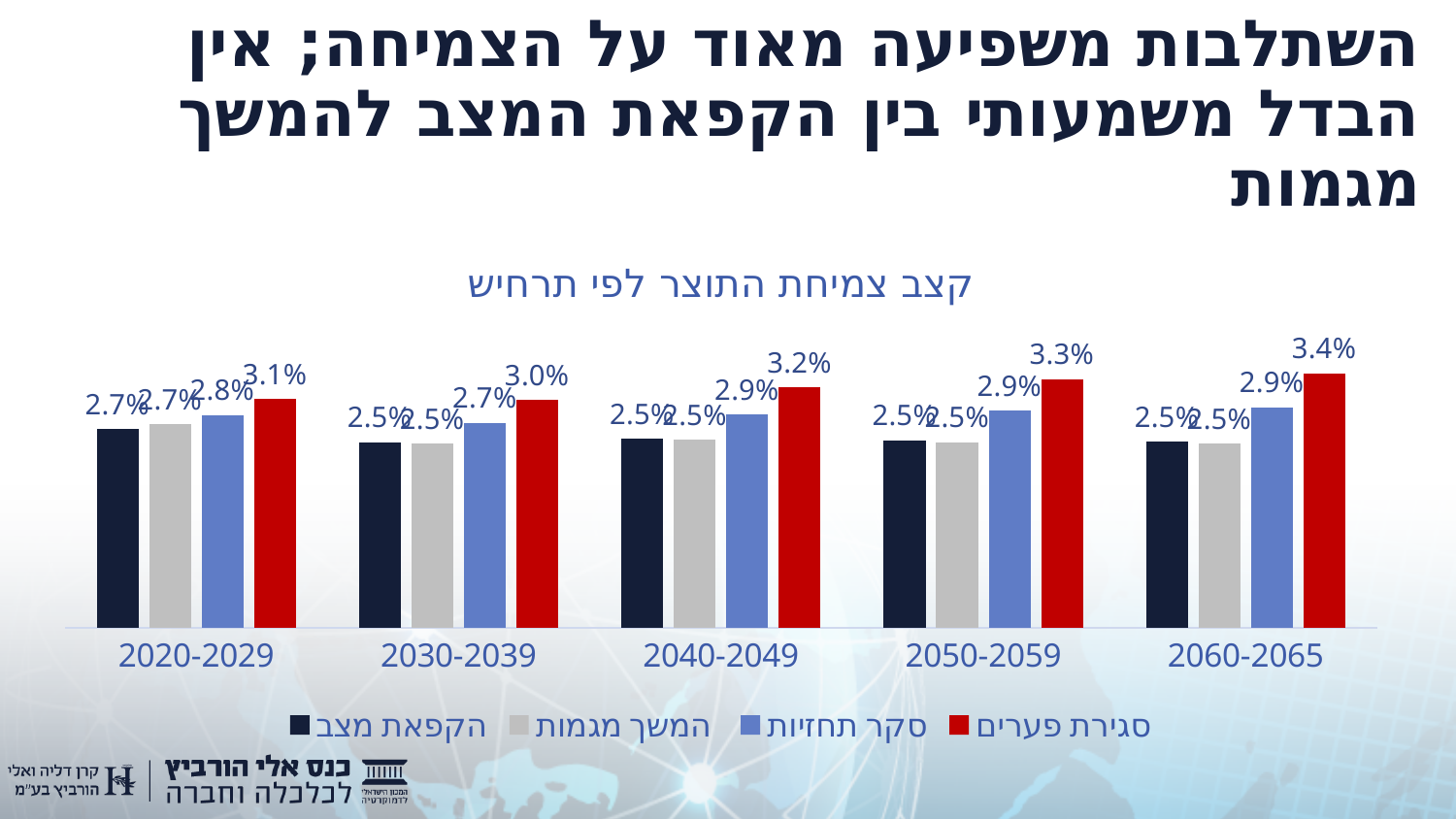
What is the value for סקר תחזיות in 2030-2039? 2.7% Which period has the highest value for סגירת פערים? 2060-2065 Which is larger in 2040-2049: סקר תחזיות or המשך מגמות? סקר תחזיות Which period has the lowest value for סגירת פערים? 2030-2039 What is the value for סגירת פערים in 2060-2065? 3.4% What is the difference between סגירת פערים and הקפאת מצב in 2060-2065? 0.9% What kind of chart is shown? bar chart Does the value for סגירת פערים rise or fall from 2030-2039 to 2060-2065? rise How many periods are shown on the x axis? 5 What is the value for הקפאת מצב in 2020-2029? 2.7% How many series does the legend list? 4 What is the value for המשך מגמות in 2050-2059? 2.5%